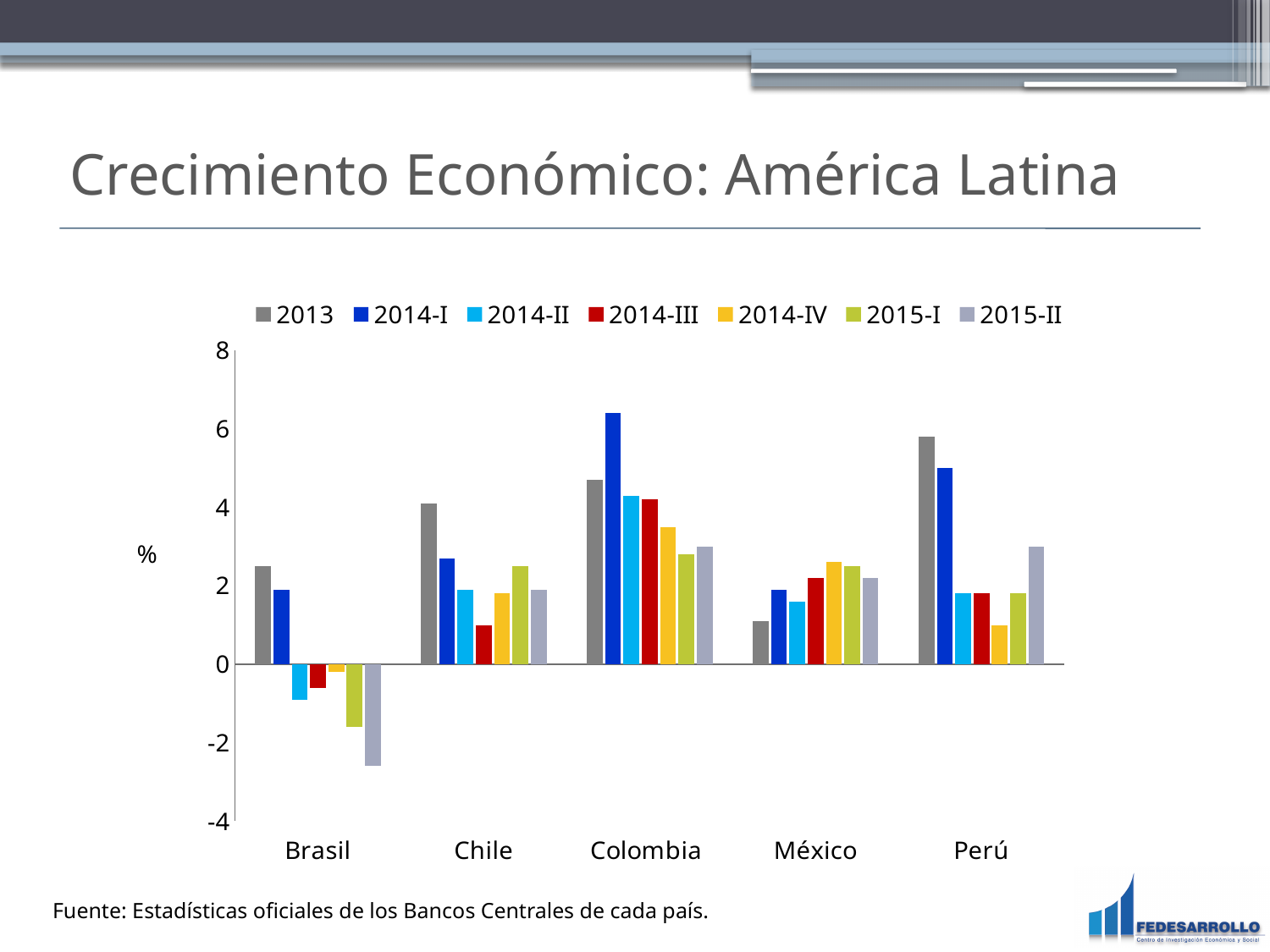
Do the values for Brasil rise or fall from 2013 to 2015-II? fall What is the unit shown on the y axis label? % Which is larger, the 2014-III value for Chile or the 2014-III value for Colombia? Colombia Which is larger, the 2013 value for Perú or the 2013 value for México? Perú Which country has the lowest 2015-II value? Brasil Is the 2015-II value for Brasil greater or less than -2? less Which country has the highest 2014-I value? Colombia How many series does the legend list? 7 What kind of chart is shown on the slide? bar chart Is the 2014-I value for Colombia greater or less than 6? greater How many countries are shown on the x axis? 5